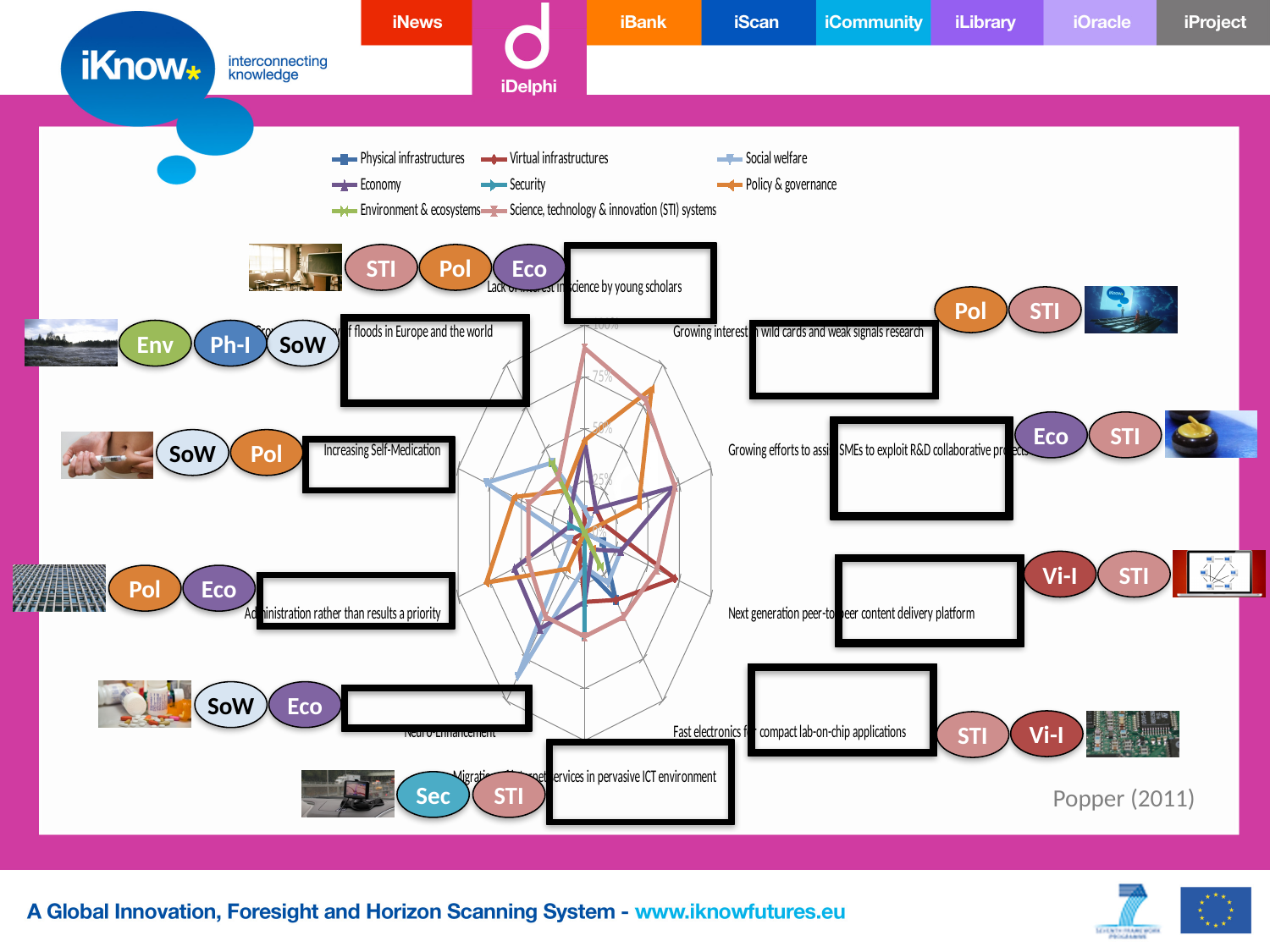
Is the value of the Environment & ecosystems series for 'Growing interest in wild cards and weak signals research' greater or less than 50%? less How many series does the chart's legend list? 8 Is the value of the Science, technology & innovation (STI) systems series for 'Lack of interest in science by young scholars' greater or less than 50%? greater How many categories (spokes) does the radar chart have? 10 What is the highest percentage tick shown on the radar chart's axis? 100% Which legend entry is shown with a green line in the chart? Environment & ecosystems What kind of chart is shown on the slide? Radar chart